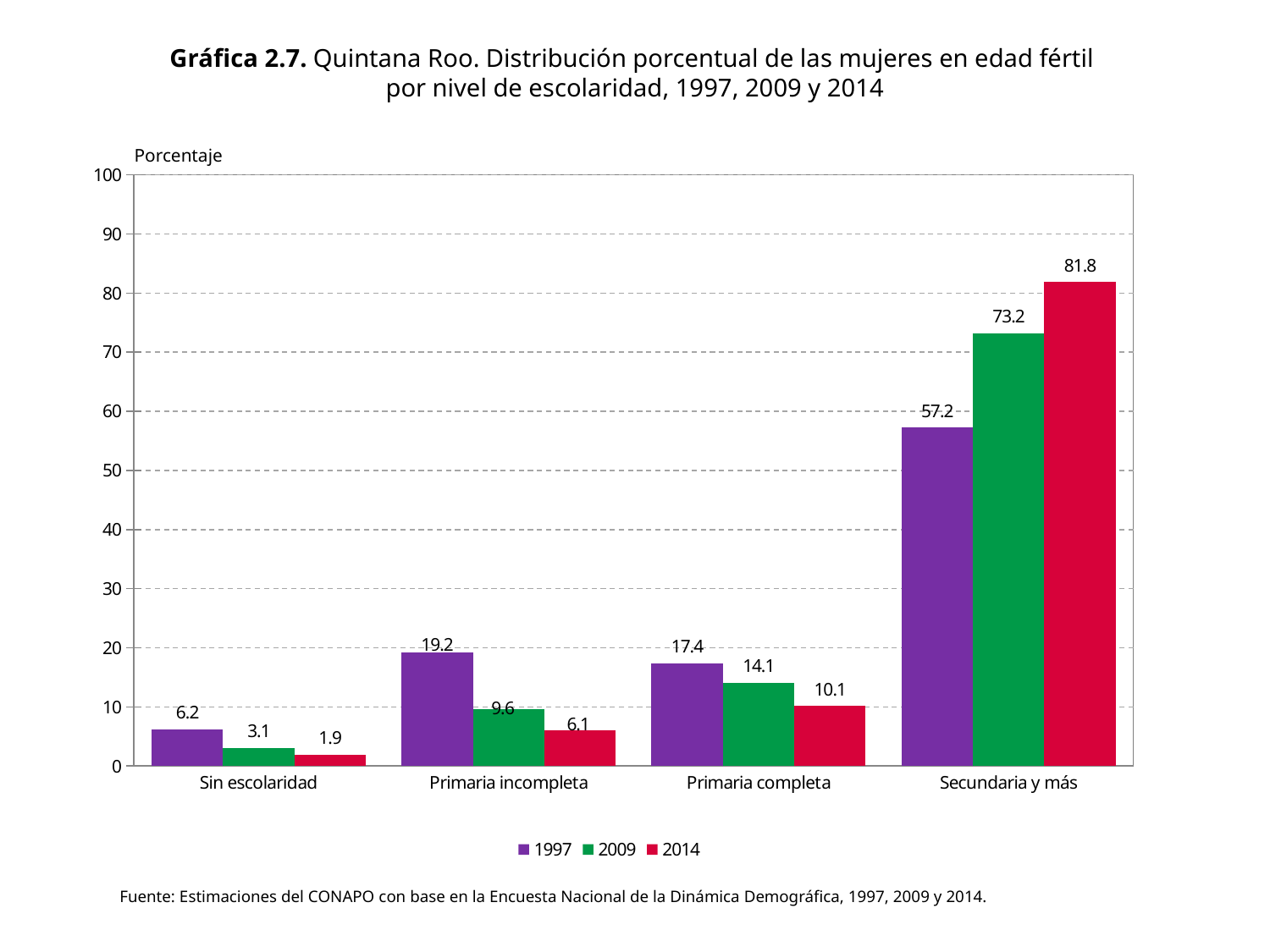
What is the value for Sin escolaridad in 1997? 6.2 What is the value for Primaria completa in 2009? 14.1 What is the value for Secundaria y más in 2014? 81.8 Which year does the red series represent in the legend? 2014 Which category has the lowest value in 2014? Sin escolaridad Is the value for Secundaria y más in 2009 greater or less than 70? greater What is the difference between the 2014 and 1997 values for Secundaria y más? 24.6 How many categories are shown on the x axis? 4 What kind of chart is shown on the slide? Bar chart Which category has the highest value in 2009? Secundaria y más How many series does the legend list? 3 Which is larger for Primaria incompleta: the 1997 value or the 2009 value? 1997